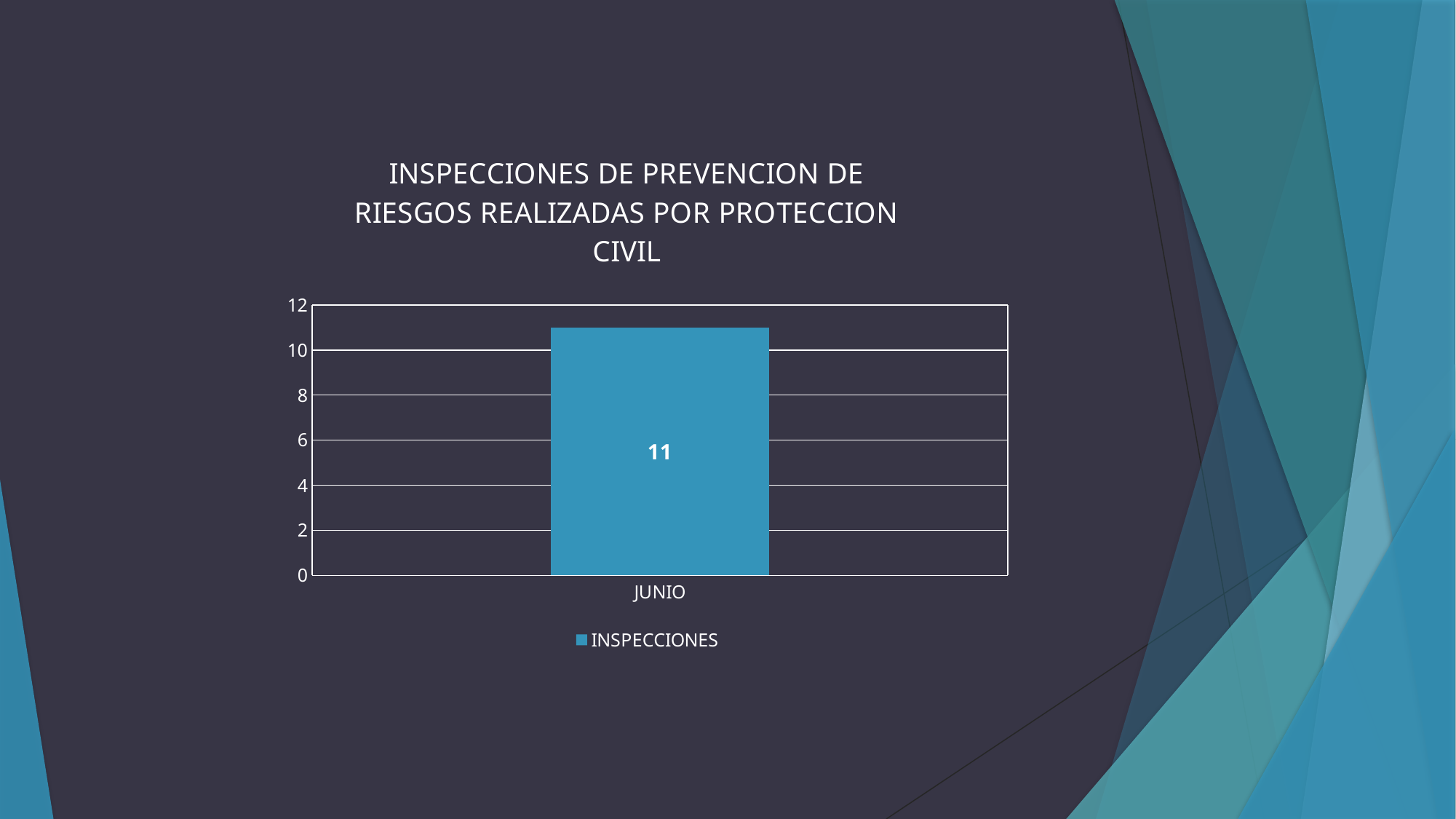
What is the maximum value shown on the y axis? 12 How many categories are plotted on the x axis? 1 What kind of chart is shown on the slide? bar chart Is the value for JUNIO greater or less than 10? greater What is the name of the series shown in the legend? INSPECCIONES Which category is shown on the x axis? JUNIO How many series does the legend list? 1 Is the value for JUNIO greater or less than 12? less What is the title of the chart? INSPECCIONES DE PREVENCION DE RIESGOS REALIZADAS POR PROTECCION CIVIL What is the value for JUNIO in the chart? 11